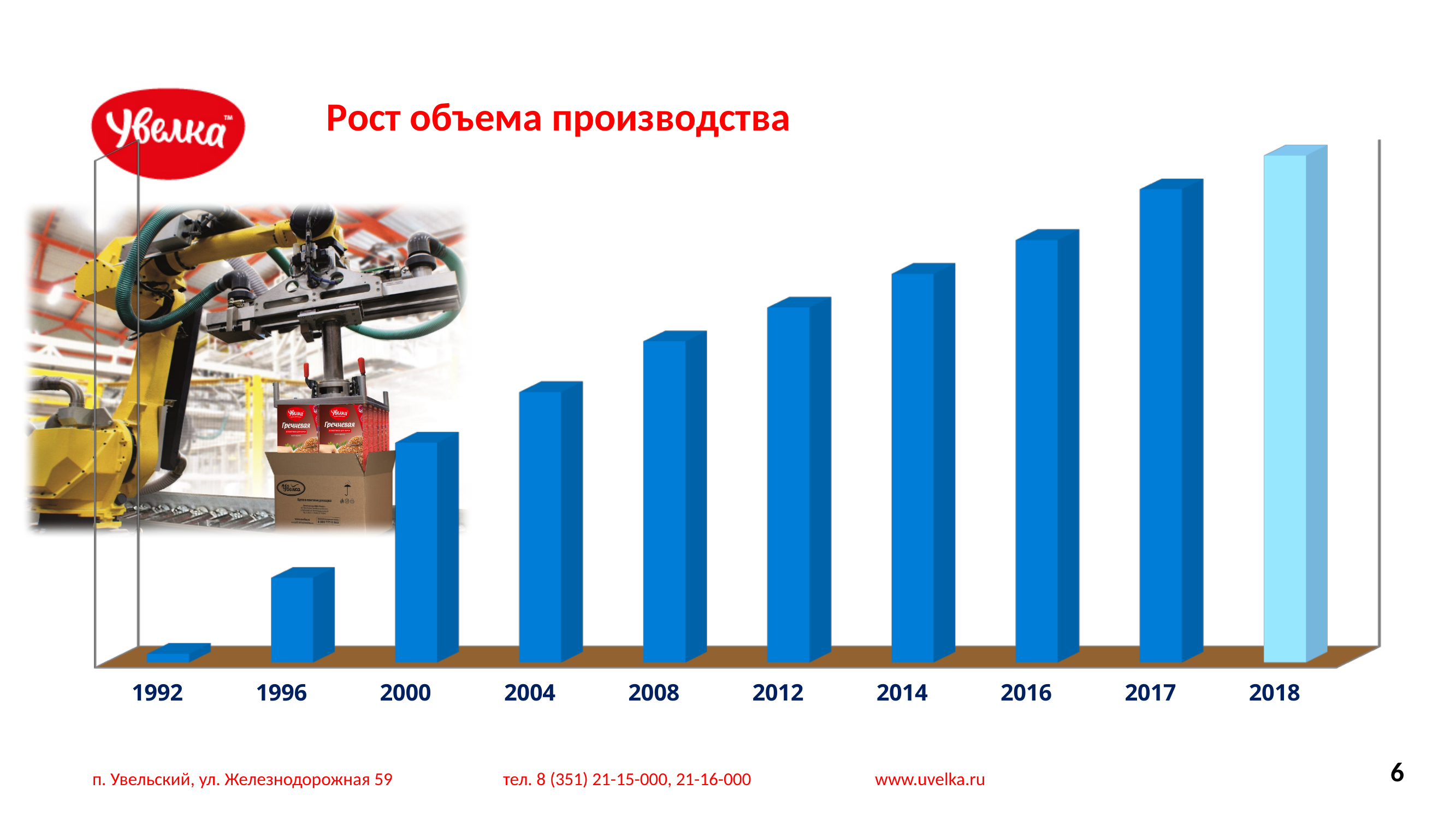
What is the first year shown on the x axis? 1992 Which is larger, the value for 2000 or the value for 1996? 2000 Do the values rise or fall from 1992 to 2018? rise Which year has the highest bar in the chart? 2018 Which is larger, the value for 2018 or the value for 2017? 2018 Which is larger, the value for 2004 or the value for 2008? 2008 What is the title of the chart? Рост объема производства How many years are shown on the x axis of the chart? 10 Which year's bar is drawn in a lighter blue than the others? 2018 Which year has the lowest bar in the chart? 1992 What kind of chart is shown on the slide? bar chart